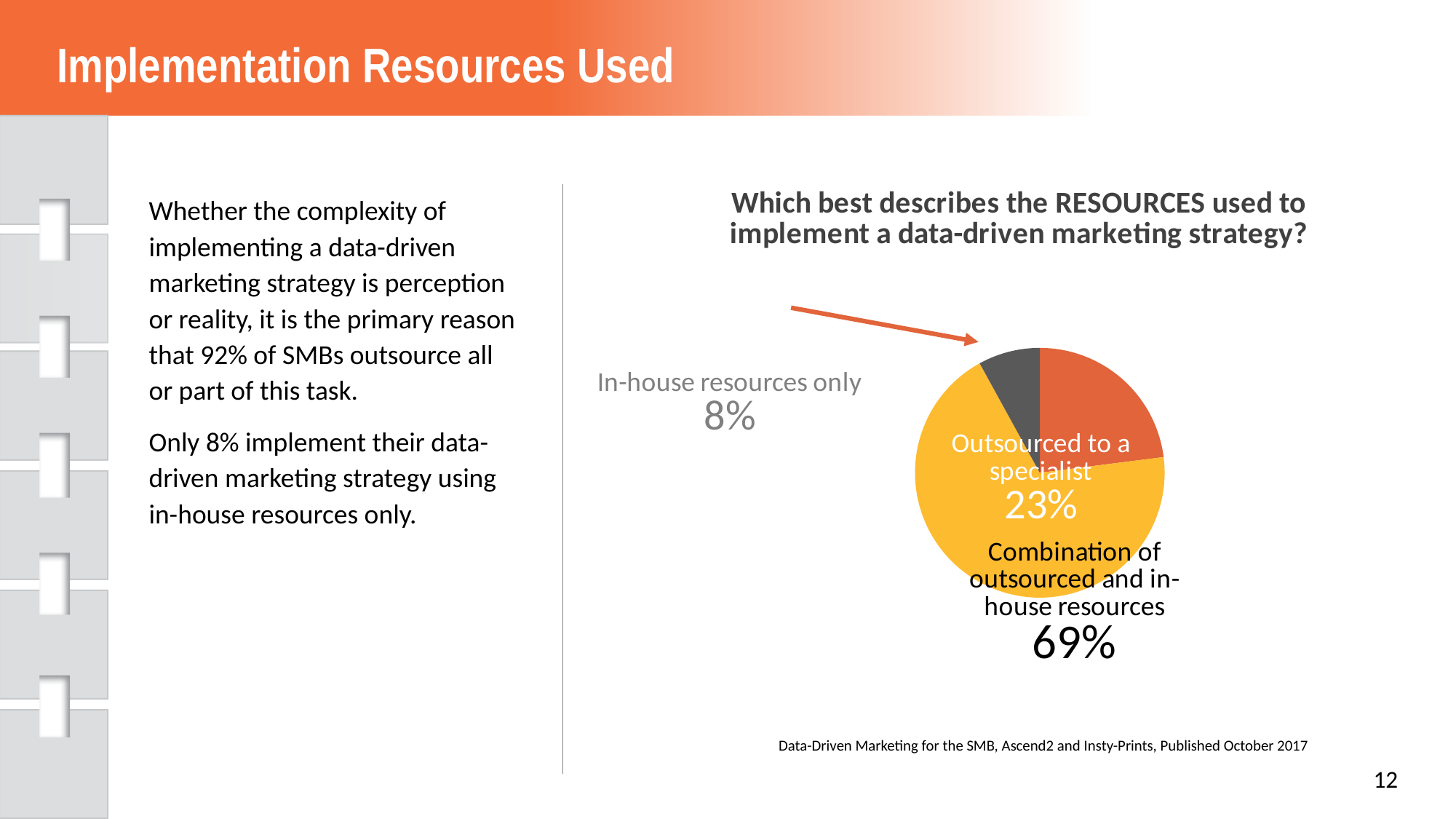
What is the title of the chart? Which best describes the RESOURCES used to implement a data-driven marketing strategy? What is the difference in percentage points between 'Outsourced to a specialist' and 'In-house resources only'? 15 Which category has the largest share of the pie? Combination of outsourced and in-house resources What colour is the slice for 'Combination of outsourced and in-house resources'? Yellow Which category has the smallest share of the pie? In-house resources only What percentage of respondents outsource to a specialist? 23% What percentage of respondents use a combination of outsourced and in-house resources? 69% Which is larger: the share for 'Outsourced to a specialist' or 'In-house resources only'? Outsourced to a specialist What percentage of respondents use in-house resources only? 8% What type of chart is shown on the slide? Pie chart What is the difference in percentage points between 'Combination of outsourced and in-house resources' and 'Outsourced to a specialist'? 46 How many categories are shown in the pie chart? 3